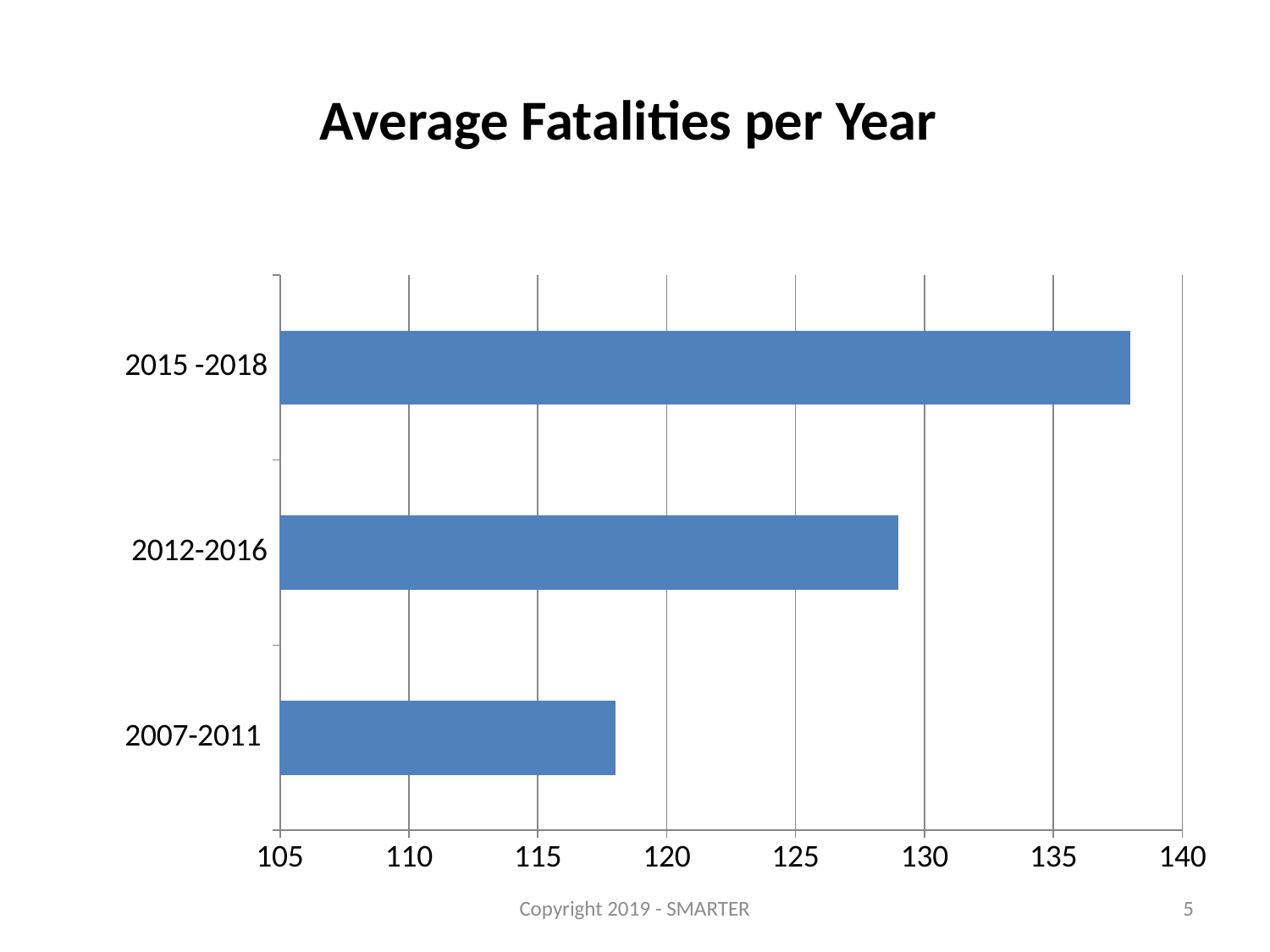
What kind of chart is shown on the slide? bar chart Is the value for 2015 -2018 greater or less than 135? greater How many categories (time periods) are plotted in the chart? 3 Which is larger, the value for 2015 -2018 or the value for 2012-2016? 2015 -2018 Do the average fatalities per year rise or fall from the 2007-2011 period to the 2015 -2018 period? rise Is the value for 2007-2011 greater or less than 120? less What is the title of the chart? Average Fatalities per Year Which period has the lowest average fatalities per year? 2007-2011 Is the value for 2012-2016 greater or less than 125? greater What is the highest value shown on the horizontal axis of the chart? 140 Which period has the highest average fatalities per year? 2015 -2018 Which is larger, the value for 2012-2016 or the value for 2007-2011? 2012-2016